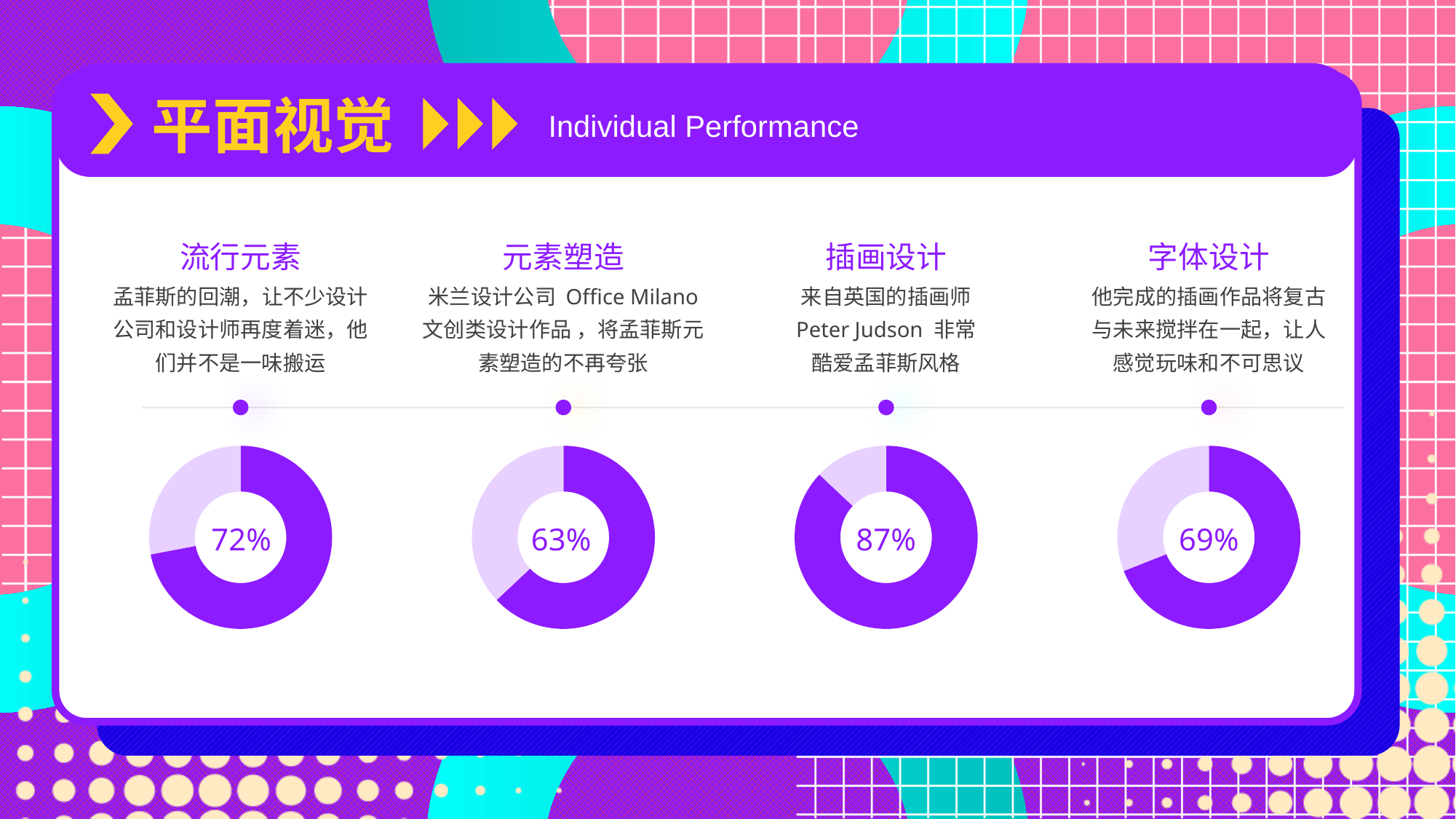
Which of the four donut charts shows the highest percentage? 插画设计 What percentage is shown in the donut chart under 字体设计? 69% What percentage is shown in the donut chart under 插画设计? 87% What kind of chart is used to show the percentages on the slide? Donut chart Which of the four donut charts shows the lowest percentage? 元素塑造 What percentage is shown in the donut chart under 流行元素? 72% What is the English subtitle shown in the slide's title bar? Individual Performance Is the percentage shown for 字体设计 greater or less than 50%? greater What percentage is shown in the donut chart under 元素塑造? 63% How many donut charts are on the slide? 4 Which is larger, the percentage for 流行元素 or the percentage for 字体设计? 流行元素 What is the difference between the percentages shown for 插画设计 and 元素塑造? 24%